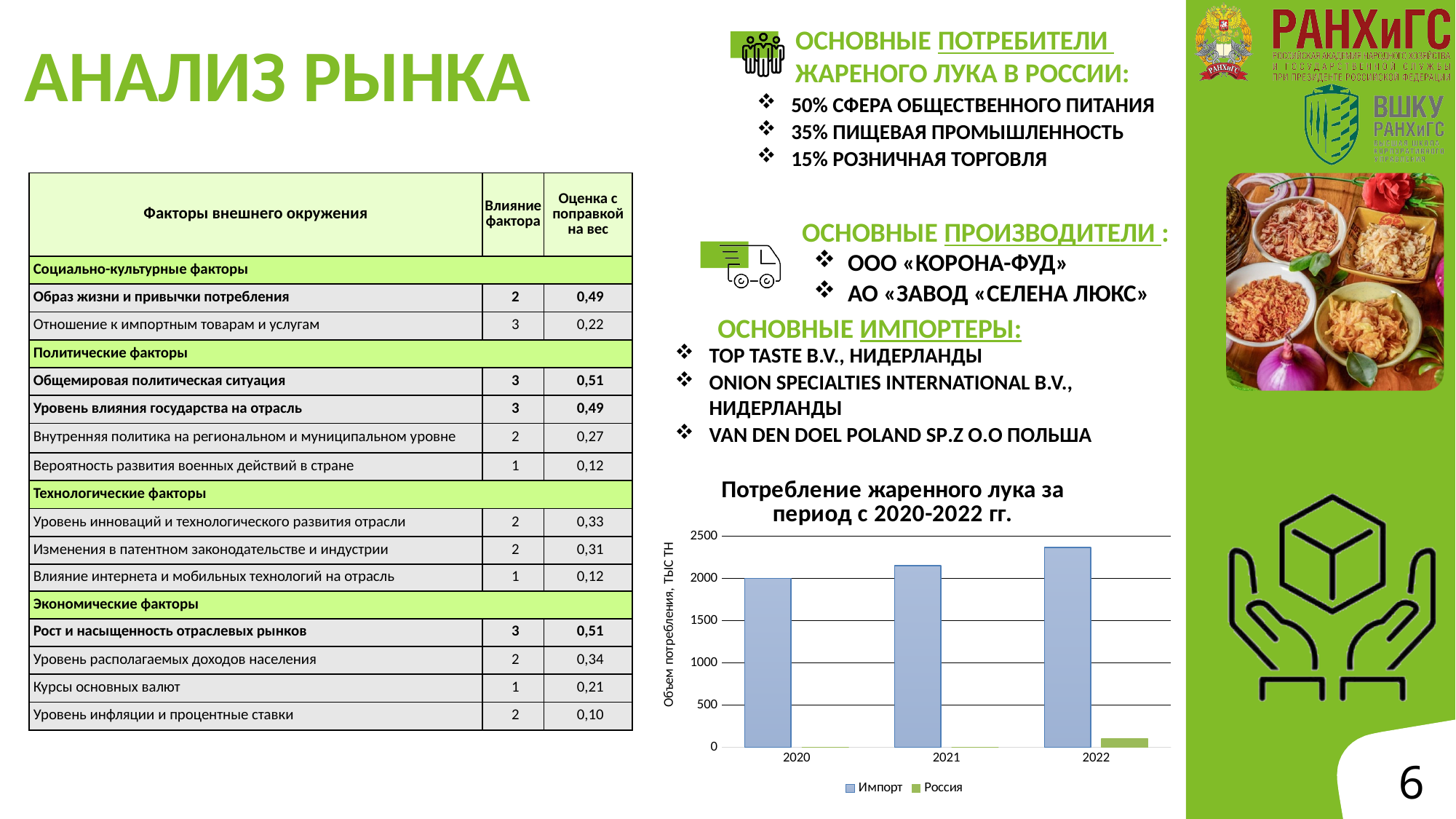
How many years are shown on the x axis of the chart? 3 In 2022, which series has the larger value, Импорт or Россия? Импорт Do the values for Импорт rise or fall from 2020 to 2022? rise What kind of chart is shown on the slide? bar chart Is the value for Импорт in 2021 greater or less than 2500? less What is the label of the vertical axis of the chart? Объем потребления, тыс тн How many series does the legend of the chart list? 2 What is the title of the chart? Потребление жаренного лука за период с 2020-2022 гг. Which year has the highest value for Импорт? 2022 Which year has the lowest value for Импорт? 2020 Is the value for Импорт in 2022 greater or less than 2000? greater Is the value for Россия in 2022 greater or less than 500? less